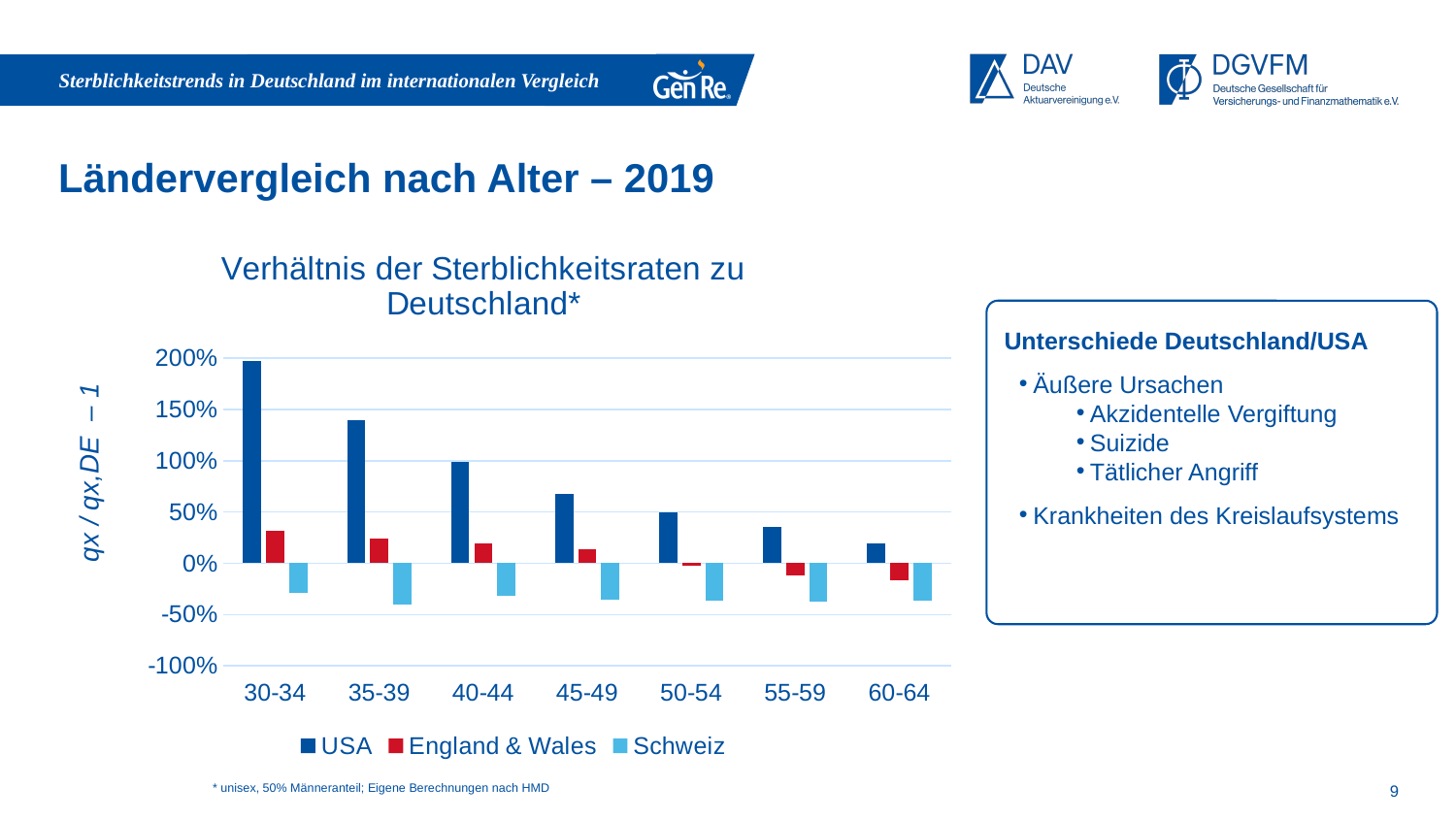
For age group 30-34, which is larger: the USA value or the England & Wales value? USA Which series are listed in the chart's legend? USA, England & Wales, Schweiz Is the Schweiz value for age group 35-39 greater or less than 0%? less What is the title of the chart? Verhältnis der Sterblichkeitsraten zu Deutschland* Is the USA value for age group 60-64 greater or less than 50%? less How many series does the chart's legend list? 3 Is the USA value for age group 30-34 greater or less than 150%? greater For which age group is the USA value lowest? 60-64 How many age groups are shown on the x axis of the chart? 7 For which age group is the USA value highest? 30-34 What kind of chart is shown on the slide? bar chart Do the USA values rise or fall as age increases along the x axis? fall